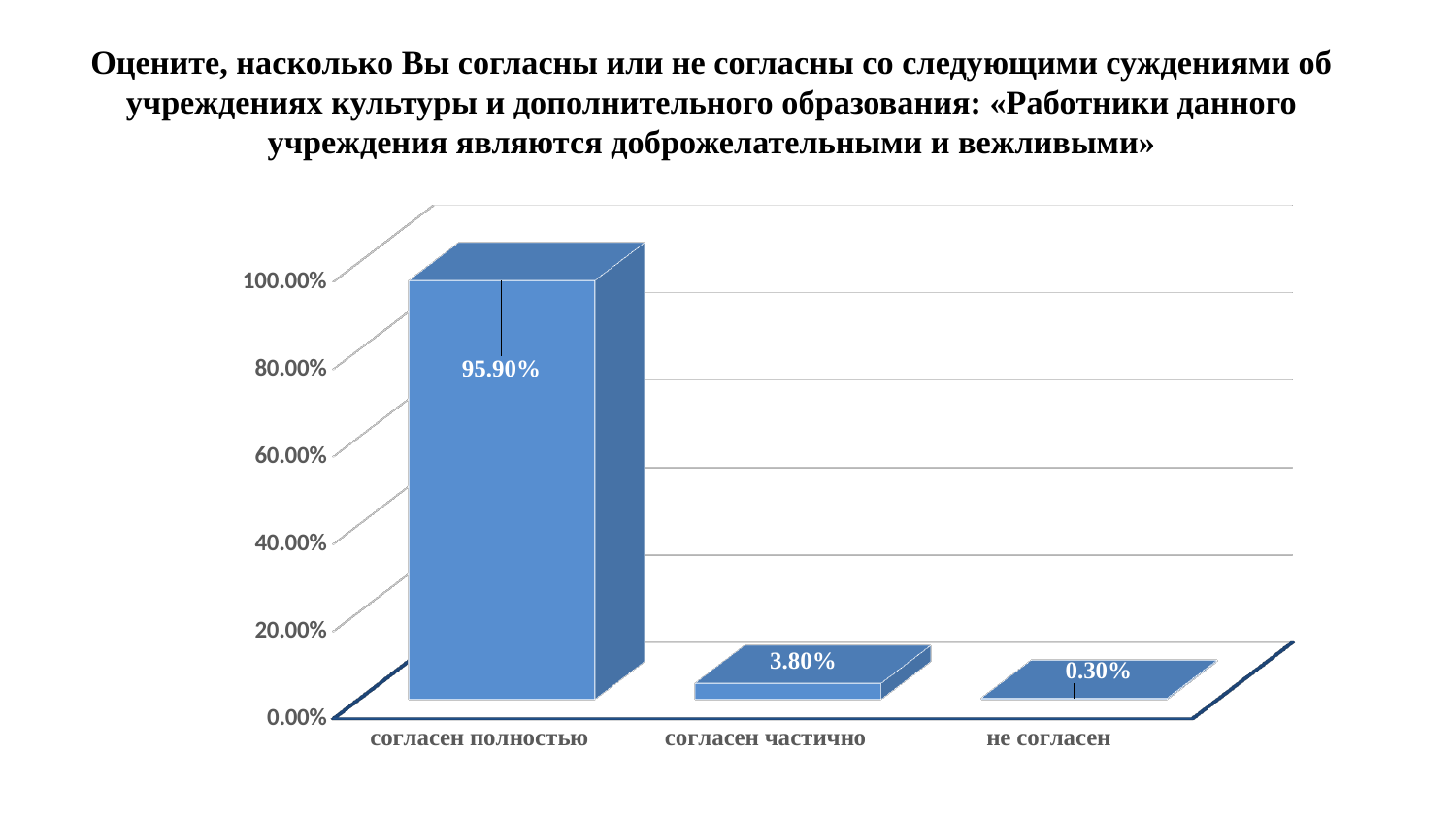
What is the difference between the values for «согласен полностью» and «согласен частично»? 92.10% What is the value for «согласен полностью»? 95.90% Which category has the highest value? согласен полностью What is the value for «согласен частично»? 3.80% How many categories are shown on the x axis? 3 Do the values rise or fall from left to right along the x axis? fall What is the value for «не согласен»? 0.30% What kind of chart is shown on the slide? bar chart Which is larger, the value for «согласен частично» or the value for «не согласен»? согласен частично What is the difference between the values for «согласен частично» and «не согласен»? 3.50% Which category has the lowest value? не согласен Is the value for «согласен полностью» greater or less than 80.00%? greater